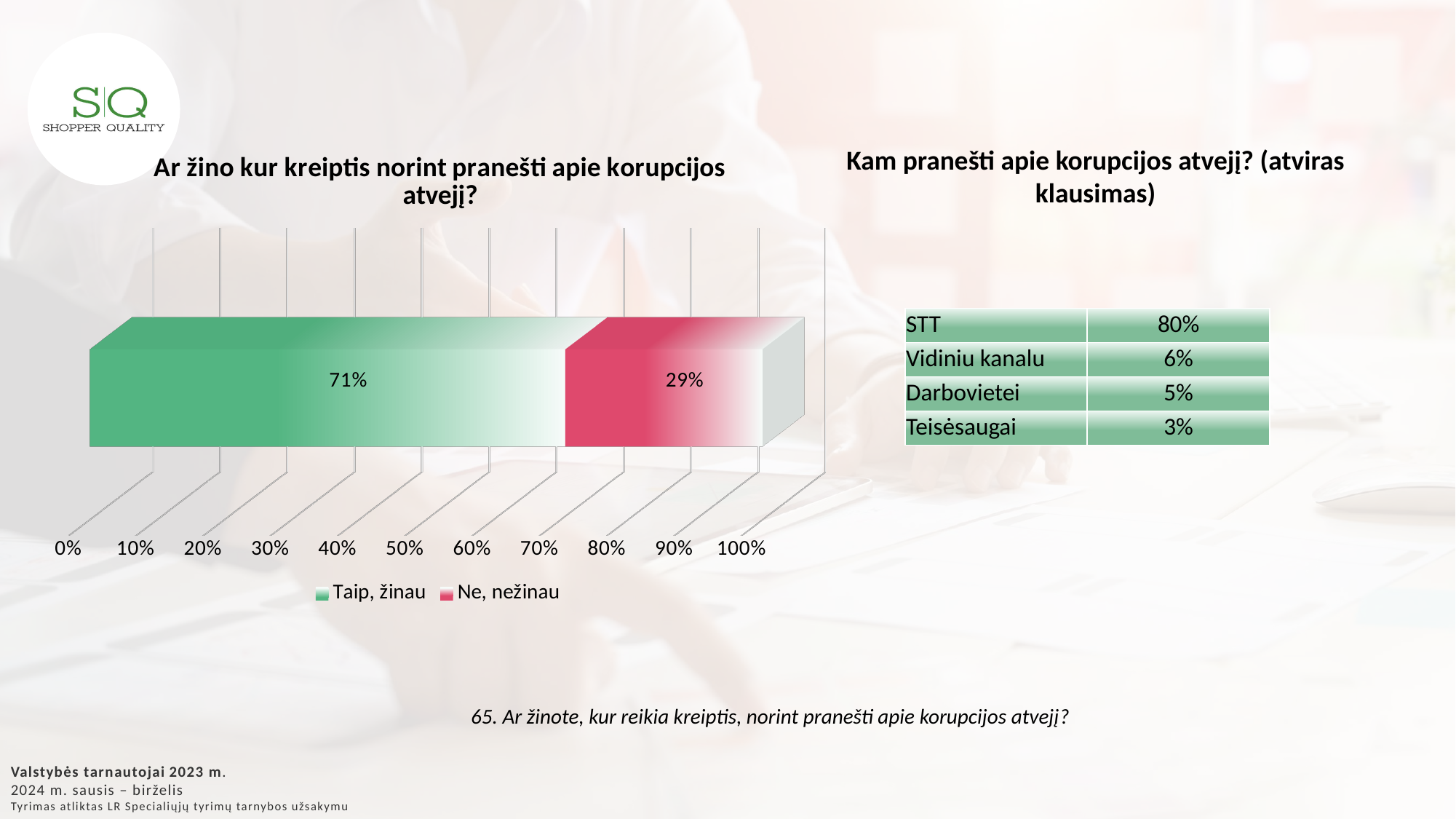
What colour represents "Ne, nežinau" in the chart? Red How many series does the chart legend list? 2 What is the highest value shown on the chart's percentage axis? 100% Which series has the smallest value in the chart? Ne, nežinau What percentage of respondents answered "Ne, nežinau" in the chart? 29% Is the value for "Taip, žinau" greater or less than 50%? greater What kind of chart is shown on the left of the slide? Stacked bar chart What percentage of respondents answered "Taip, žinau" in the chart "Ar žino kur kreiptis norint pranešti apie korupcijos atvejį?"? 71% What is the total of the two segments of the stacked bar? 100% Which answer has the larger share in the chart, "Taip, žinau" or "Ne, nežinau"? Taip, žinau Is the value for "Ne, nežinau" greater or less than 30%? less What is the difference in percentage points between "Taip, žinau" and "Ne, nežinau"? 42